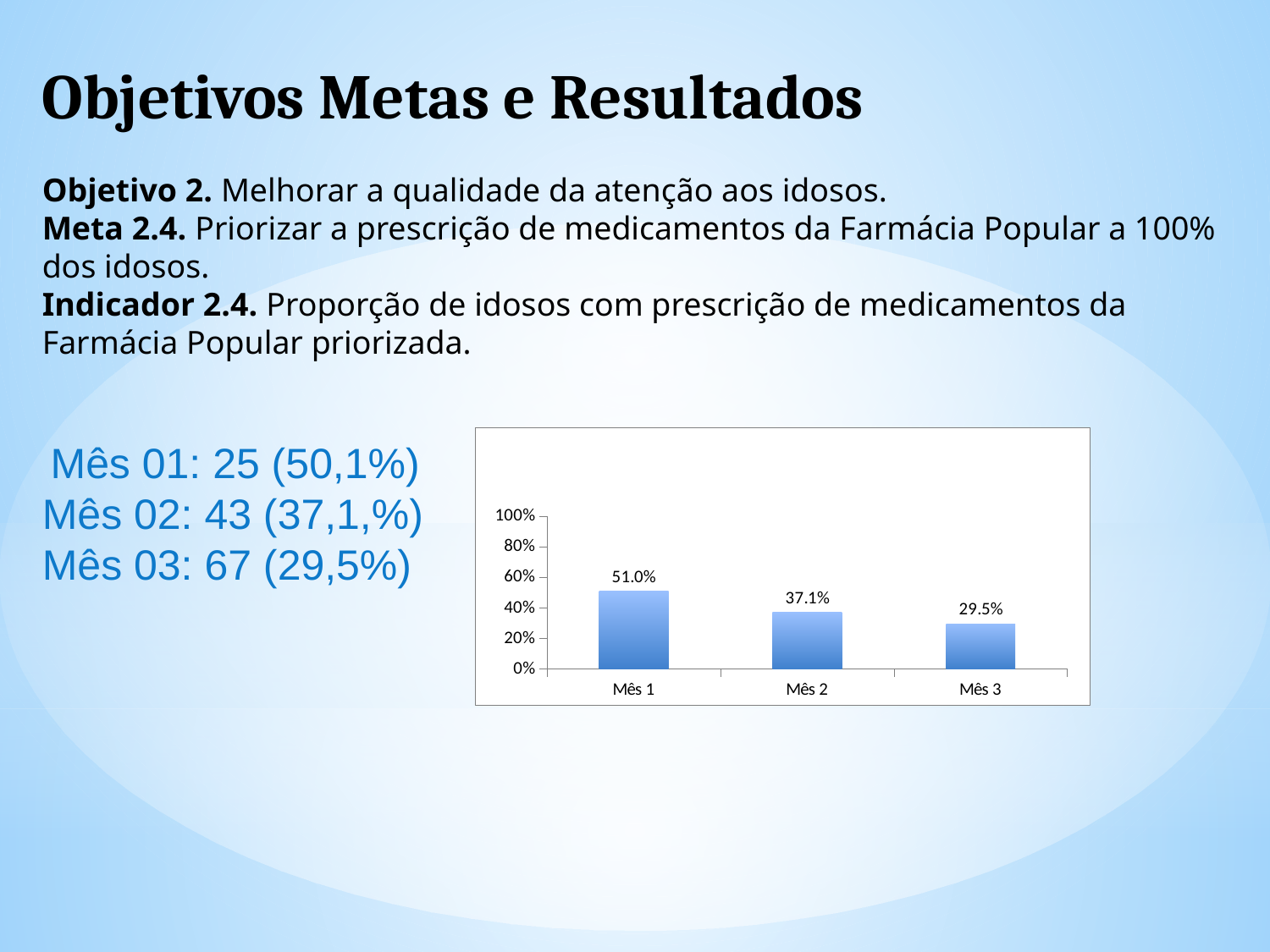
Is the value for Mês 1 greater or less than 40%? greater What is the value for Mês 3? 29.5% What kind of chart is shown on the slide? bar chart Which month has the lowest value? Mês 3 What is the value for Mês 1? 51.0% Which is larger, the value for Mês 2 or the value for Mês 3? Mês 2 What is the value for Mês 2? 37.1% What is the difference between the values for Mês 1 and Mês 2? 13.9% Which month has the highest value? Mês 1 What is the difference between the values for Mês 1 and Mês 3? 21.5% Do the values rise or fall from Mês 1 to Mês 3? fall How many categories are shown on the x axis? 3